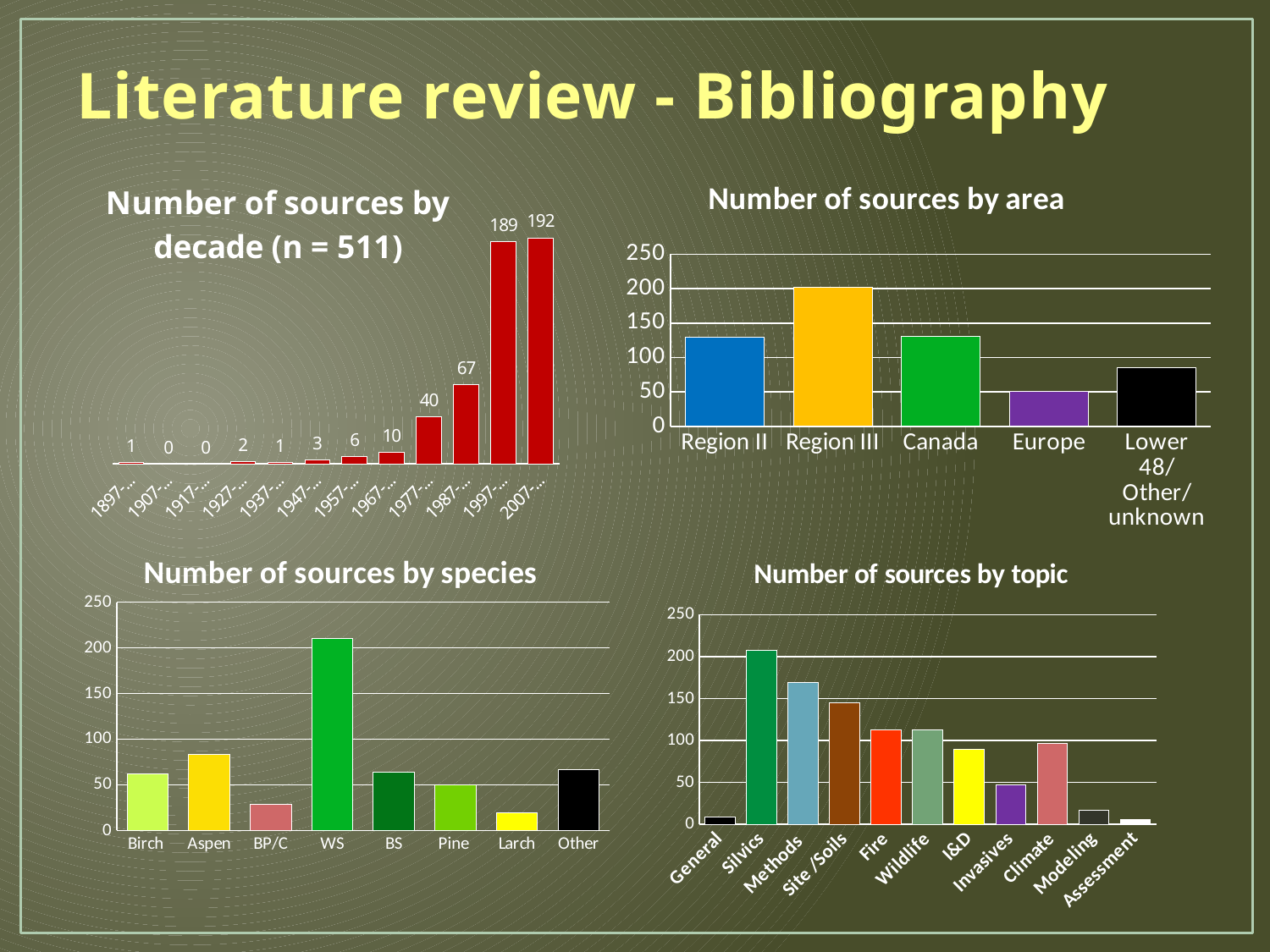
In the 'Number of sources by species' chart, which species has the lowest number of sources? Larch In the 'Number of sources by decade (n = 511)' chart, what is the value for the 1987-… decade? 67 In the 'Number of sources by decade (n = 511)' chart, what is the value for the 2007-… decade? 192 In the 'Number of sources by species' chart, which species has the highest number of sources? WS In the 'Number of sources by species' chart, how many species categories are shown? 8 In the 'Number of sources by area' chart, which area has the highest number of sources? Region III In the 'Number of sources by decade (n = 511)' chart, what is the difference between the values for 2007-… and 1997-…? 3 In the 'Number of sources by area' chart, which area has the lowest number of sources? Europe In the 'Number of sources by decade (n = 511)' chart, how many decade categories are shown? 12 In the 'Number of sources by topic' chart, which topic has the highest number of sources? Silvics In the 'Number of sources by area' chart, is the value for Region III greater or less than 150? greater What kind of chart is 'Number of sources by topic'? bar chart